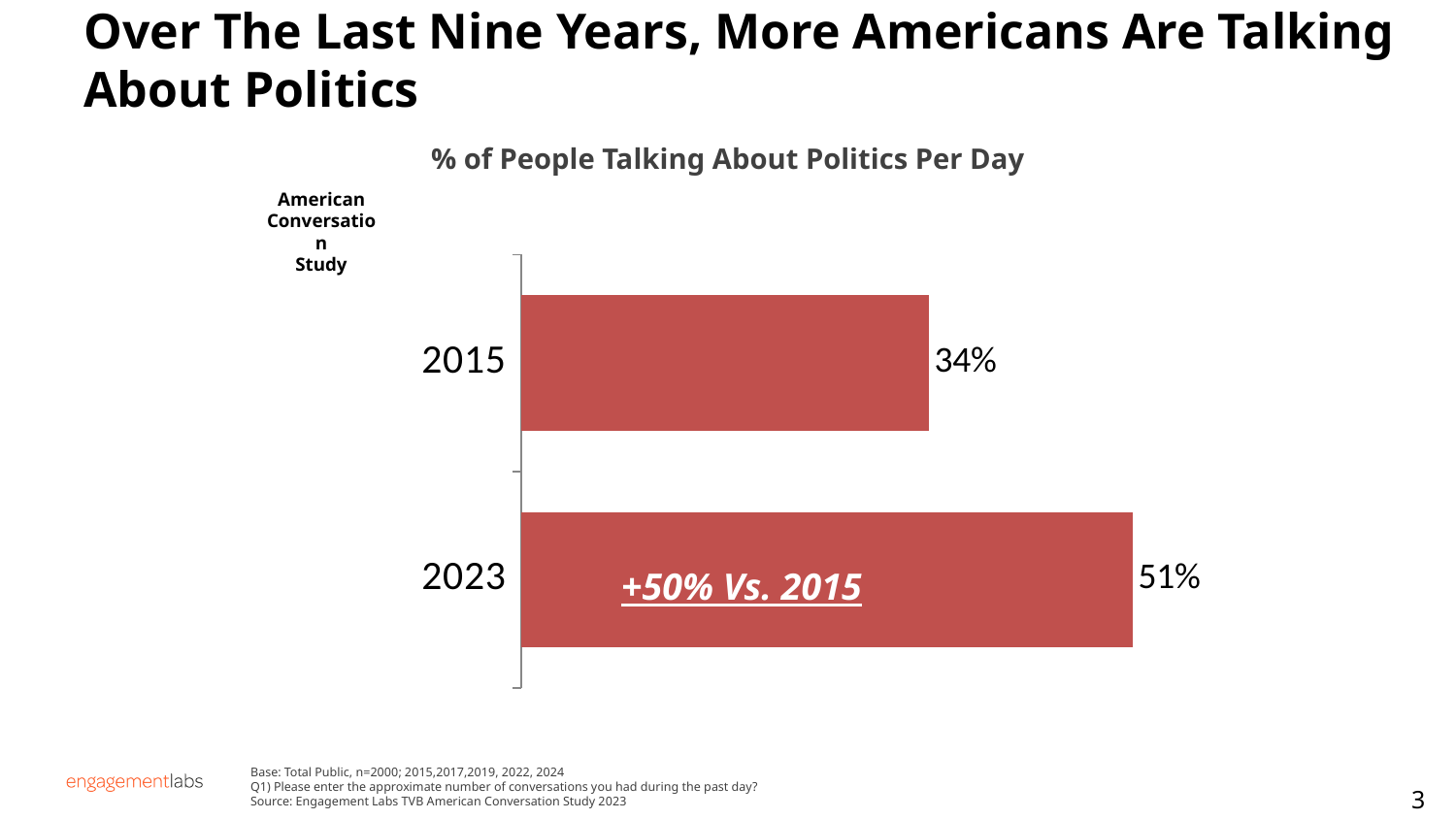
What kind of chart is shown on the slide? Bar chart What annotation is written on the 2023 bar? +50% Vs. 2015 Which year has the lowest percentage of people talking about politics per day? 2015 How many years are shown in the chart? 2 Do the values rise or fall from 2015 to 2023? Rise Which year has the highest percentage of people talking about politics per day? 2023 What is the value for 2023? 51% What is the difference in percentage points between 2023 and 2015? 17 percentage points What is the title of the chart? % of People Talking About Politics Per Day Which is larger, the value for 2015 or the value for 2023? 2023 What is the value for 2015? 34%